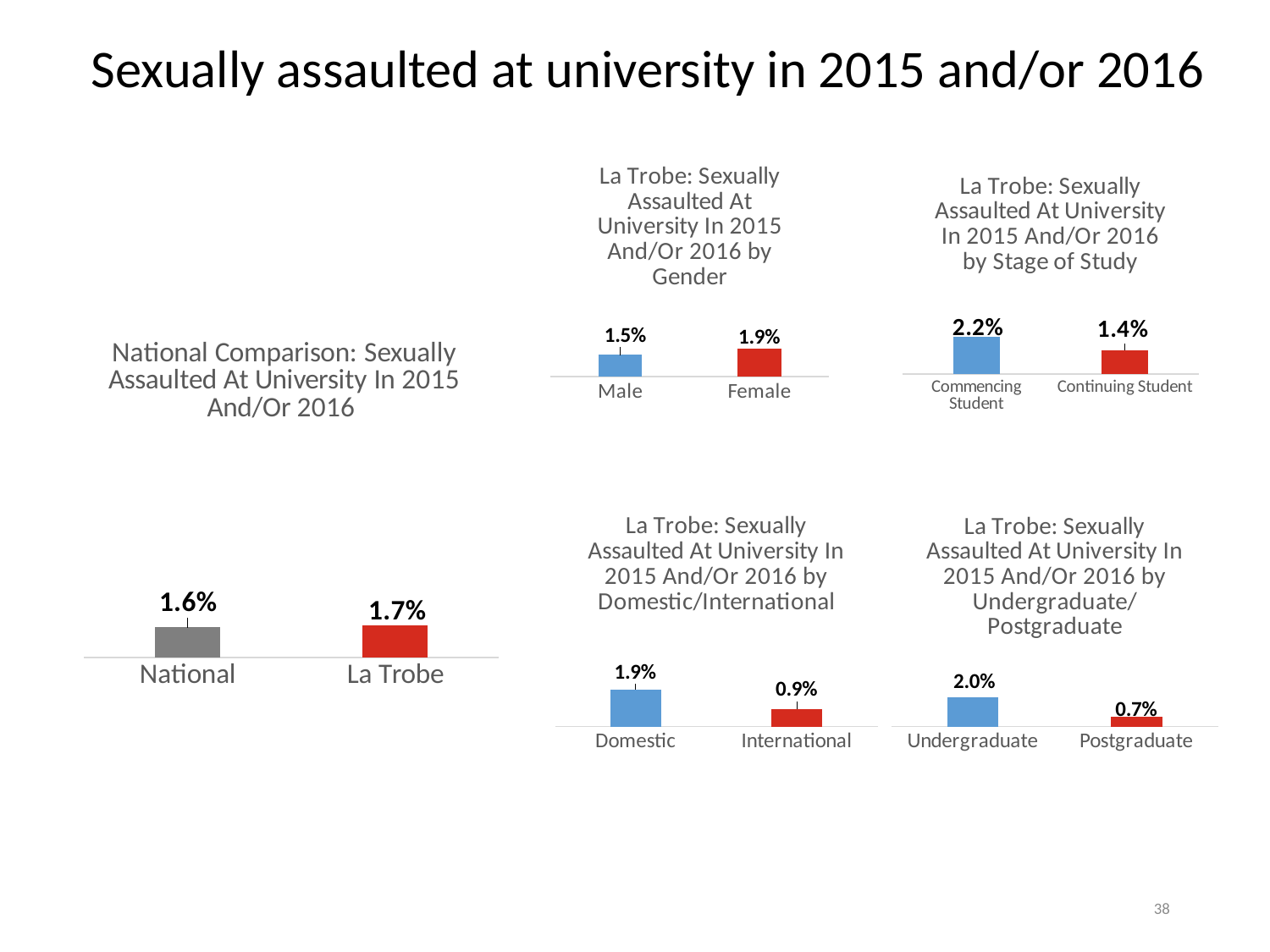
In the 'National Comparison' chart, what is the value for National? 1.6% In the 'by Stage of Study' chart, what is the value for Continuing Student? 1.4% How many charts are shown on the slide? 5 In the 'by Stage of Study' chart, which category has the higher value? Commencing Student In the 'by Domestic/International' chart, what is the difference between the Domestic and International values? 1.0% In the 'National Comparison' chart, what is the value for La Trobe? 1.7% In the 'by Domestic/International' chart, what is the value for International? 0.9% In the 'by Undergraduate/Postgraduate' chart, what is the value for Undergraduate? 2.0% In the 'by Gender' chart, what is the difference between the Female and Male values? 0.4% In the 'by Gender' chart, what is the value for Female? 1.9% What kind of chart is the 'by Gender' chart? Bar chart In the 'by Undergraduate/Postgraduate' chart, which category has the lowest value? Postgraduate